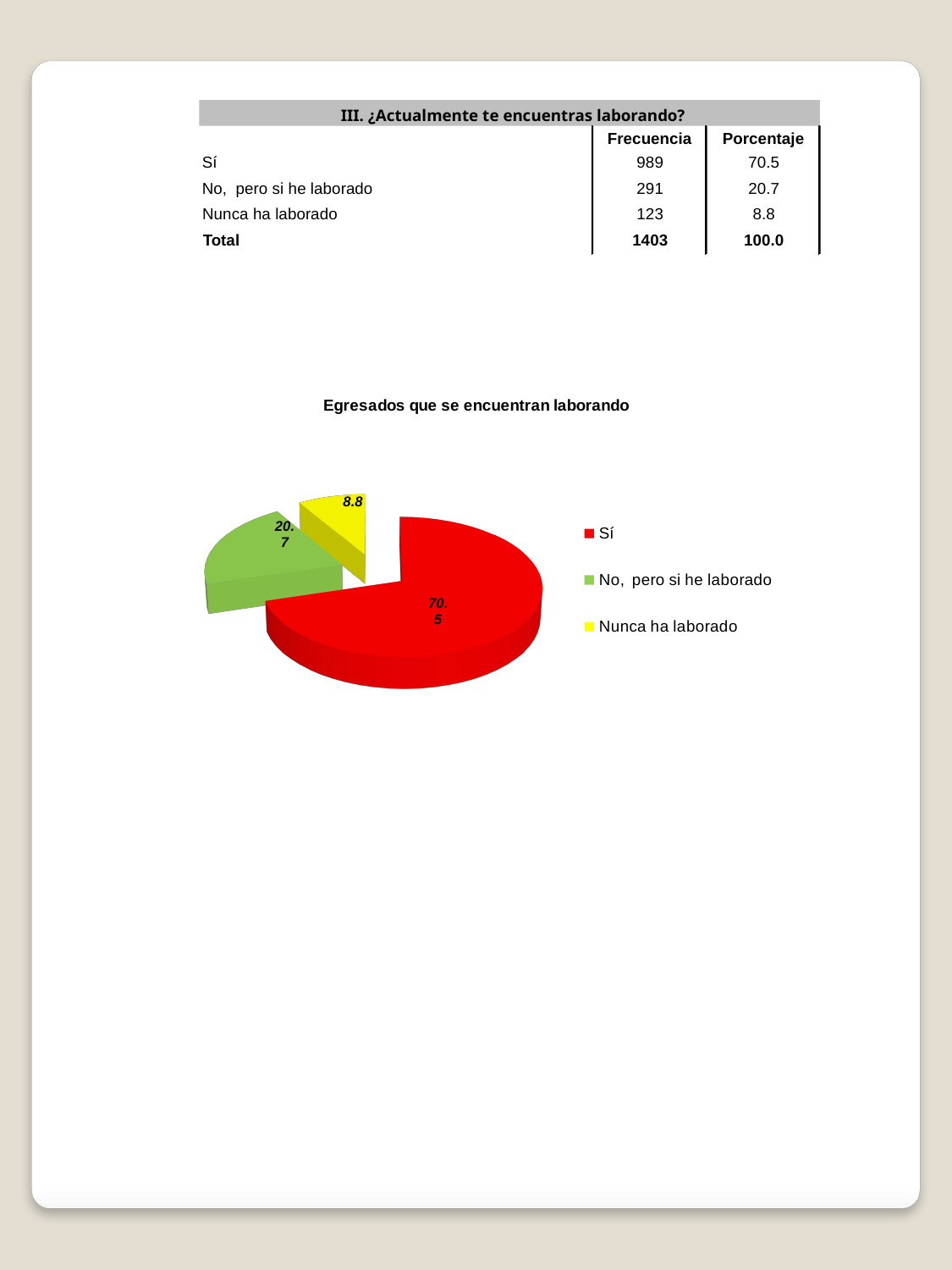
What value is shown for the "Nunca ha laborado" slice of the pie chart? 8.8 What colour is the "Sí" slice in the pie chart? red How many slices does the pie chart have? 3 What value is shown for the "No, pero si he laborado" slice of the pie chart? 20.7 What type of chart is shown on the slide? pie chart What value is shown for the "Sí" slice of the pie chart? 70.5 Which category has the largest slice in the pie chart? Sí Which category has the smallest slice in the pie chart? Nunca ha laborado What is the difference between the values for "Sí" and "No, pero si he laborado" in the pie chart? 49.8 What is the difference between the values for "No, pero si he laborado" and "Nunca ha laborado" in the pie chart? 11.9 Which is larger in the pie chart, the slice for "No, pero si he laborado" or the slice for "Nunca ha laborado"? No, pero si he laborado What is the title of the chart? Egresados que se encuentran laborando